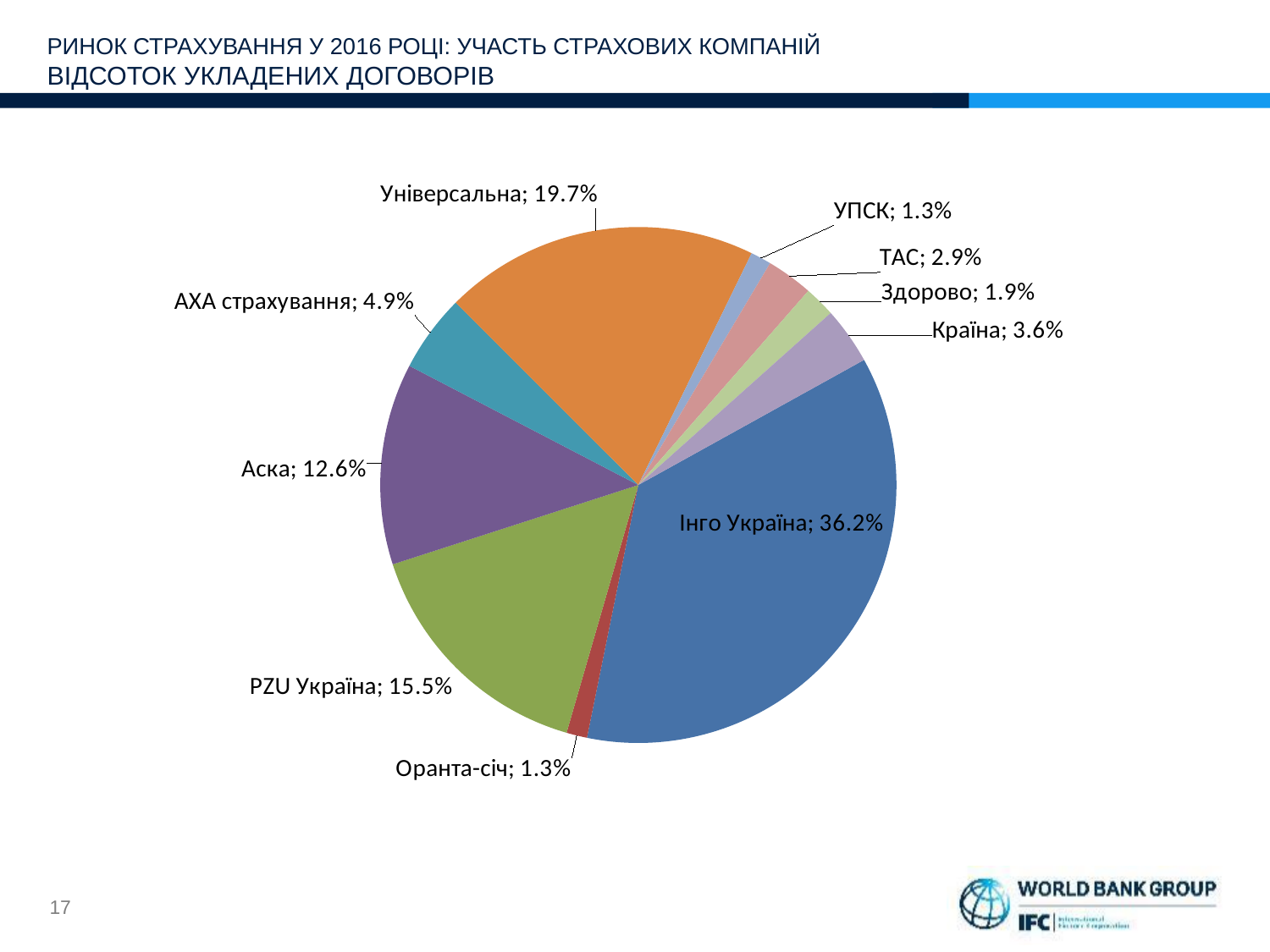
What is the value shown for Універсальна? 19.7% Which is larger, the share of Аска or the share of АХА страхування? Аска What is the difference between the shares of Інго Україна and Універсальна? 16.5% What is the value shown for Країна? 3.6% What is the difference between the shares of PZU Україна and Аска? 2.9% Which company has the largest slice of the pie? Інго Україна What is the value shown for PZU Україна? 15.5% How many slices does the pie chart have? 10 What share of the pie does Інго Україна hold? 36.2% What is the value shown for Аска? 12.6% What kind of chart is shown on the slide? pie chart What is the value shown for ТАС? 2.9%